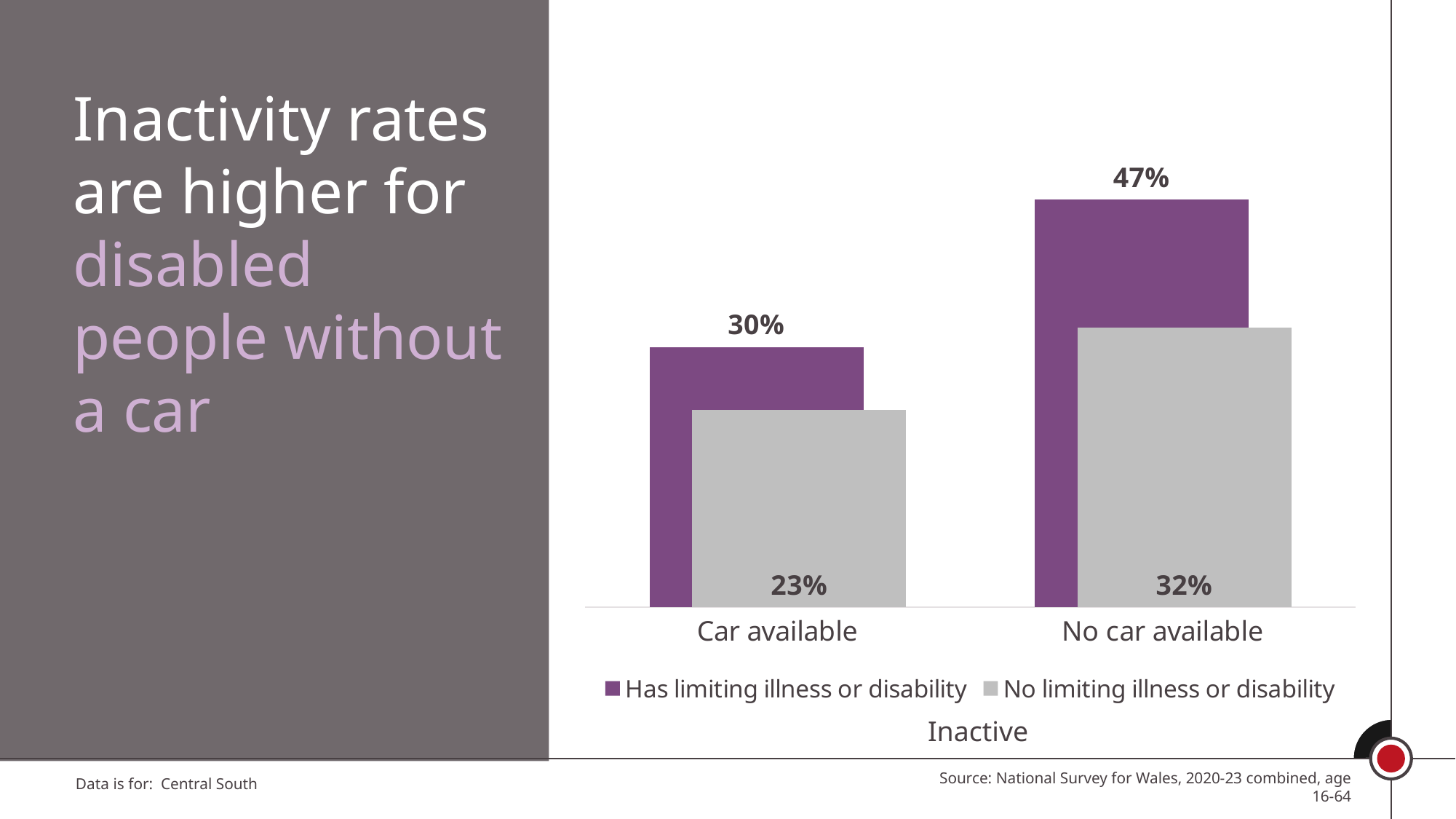
What is the difference in inactivity rate between people with and without a limiting illness or disability when a car is available? 7% Is the inactivity rate higher for people with a limiting illness or disability with a car available, or for people with no limiting illness or disability with no car available? No limiting illness or disability with no car available Which bar shows the highest inactivity rate? Has limiting illness or disability, No car available What is the inactivity rate for people with no limiting illness or disability with a car available? 23% Which bar shows the lowest inactivity rate? No limiting illness or disability, Car available What is the inactivity rate for people with no limiting illness or disability and no car available? 32% What type of chart is shown on the slide? Bar chart What is the inactivity rate for people who have a limiting illness or disability with a car available? 30% What is the difference in inactivity rate between people with and without a limiting illness or disability when no car is available? 15% What is the inactivity rate for people who have a limiting illness or disability with no car available? 47% How many series does the legend list? 2 How many categories are shown on the x axis? 2